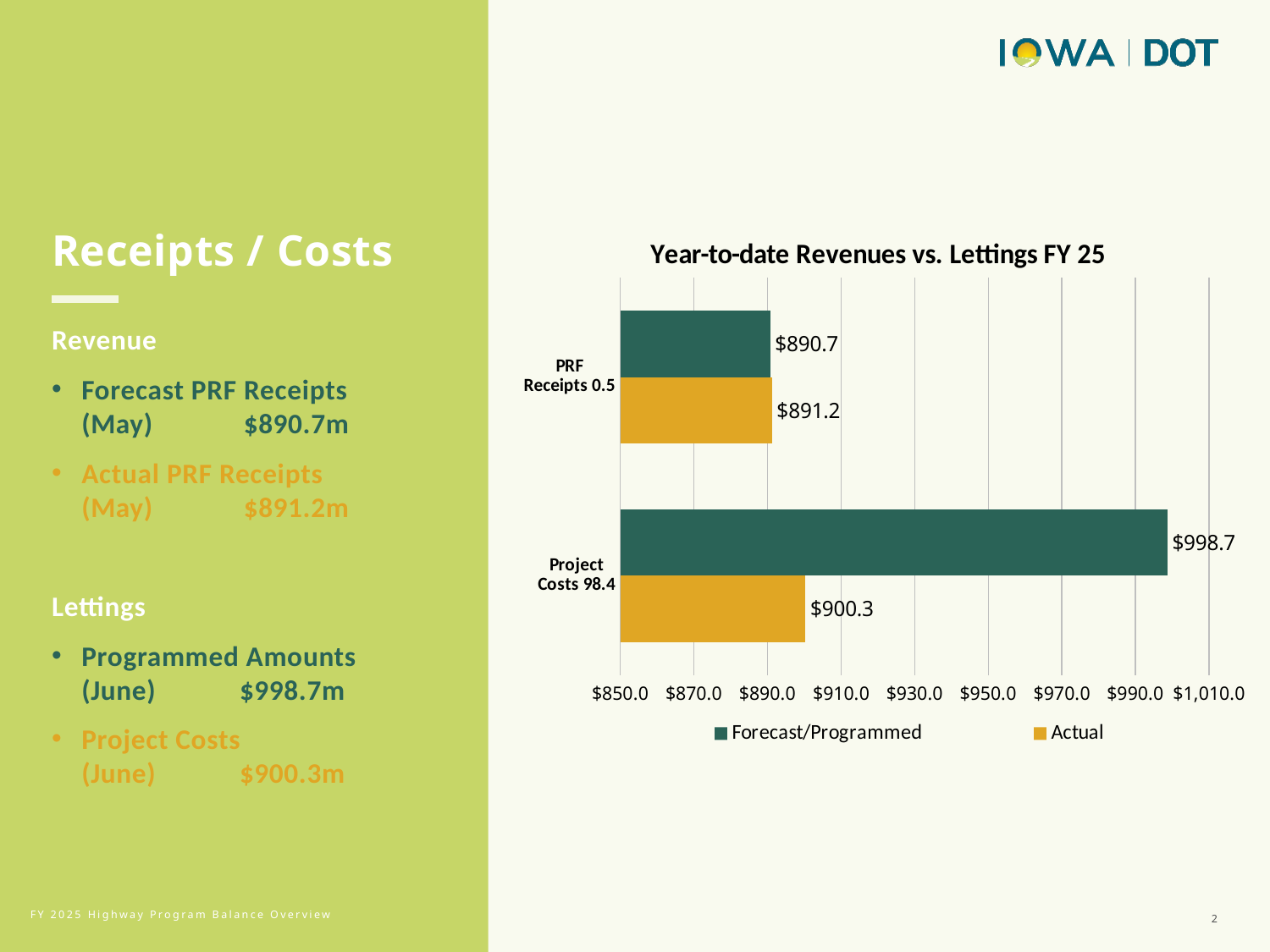
What is the difference between the Forecast/Programmed and Actual values for Project Costs? $98.4 What type of chart is shown on the slide? Bar chart Which bar in the chart has the highest value? Project Costs, Forecast/Programmed What is the difference between the Actual and Forecast/Programmed values for PRF Receipts? $0.5 For Project Costs, which is larger: the Forecast/Programmed value or the Actual value? Forecast/Programmed Which bar in the chart has the lowest value? PRF Receipts, Forecast/Programmed What is the Actual value for PRF Receipts? $891.2 What is the Forecast/Programmed value for PRF Receipts? $890.7 Is the Forecast/Programmed value for Project Costs greater or less than $990.0? greater How many series does the chart legend list? 2 What is the Forecast/Programmed value for Project Costs? $998.7 What is the Actual value for Project Costs? $900.3